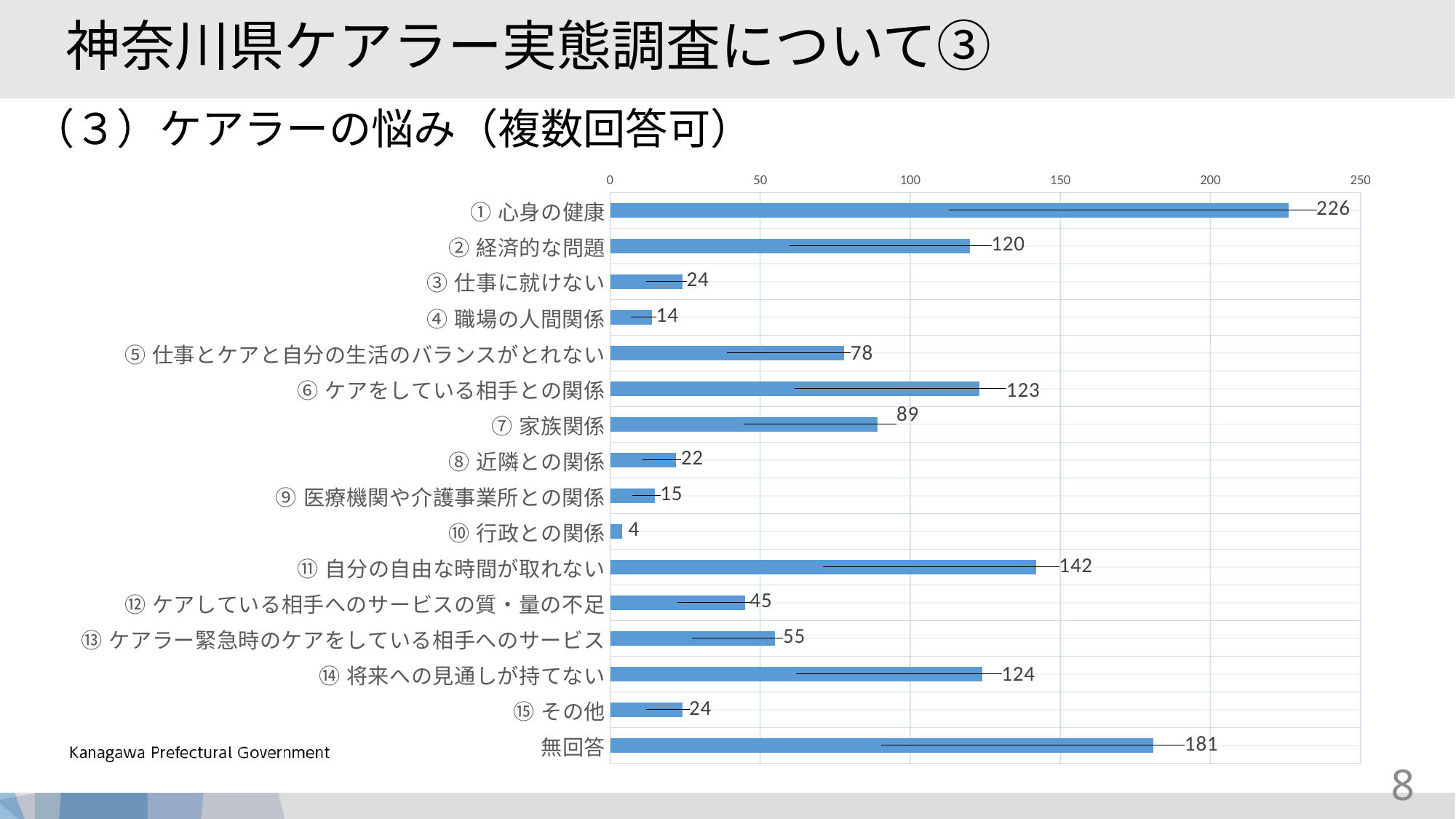
What is the difference between the values for ① 心身の健康 and ② 経済的な問題? 106 Which category has the lowest value? ⑩ 行政との関係 What is the value for ⑬ ケアラー緊急時のケアをしている相手へのサービス? 55 What is the value for 無回答? 181 What is the maximum value shown on the horizontal axis? 250 Which category has the highest value? ① 心身の健康 What is the value for ⑪ 自分の自由な時間が取れない? 142 How many categories are shown on the chart? 16 Which is larger, the value for ⑥ ケアをしている相手との関係 or ⑭ 将来への見通しが持てない? ⑭ 将来への見通しが持てない Is the value for ⑦ 家族関係 greater or less than 100? less What kind of chart is shown on the slide? bar chart What is the value for ① 心身の健康? 226